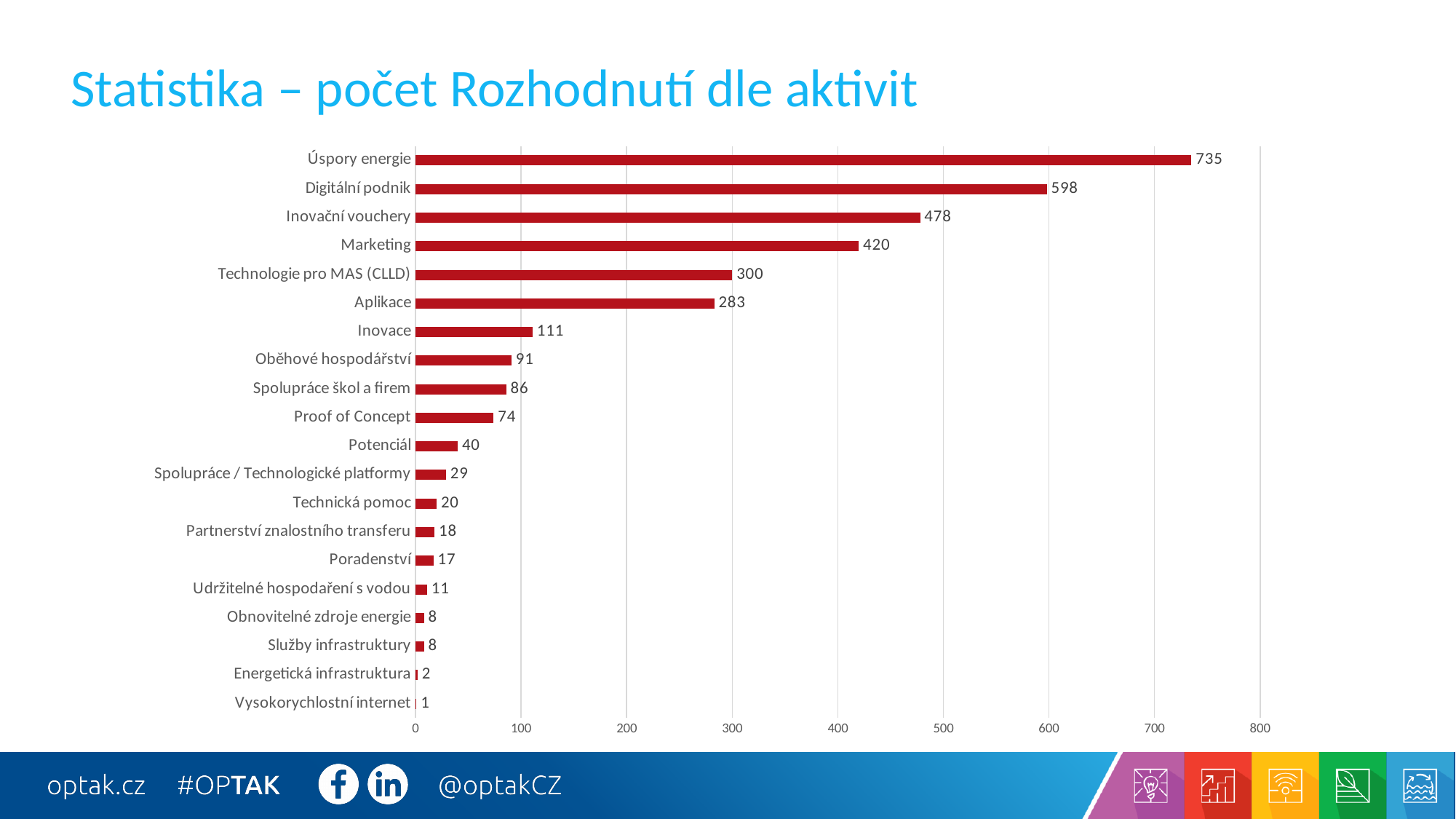
What is the title of the slide? Statistika – počet Rozhodnutí dle aktivit What kind of chart is shown on the slide? bar chart What colour are the bars in the chart? red What is the value for Technologie pro MAS (CLLD)? 300 What is the value for Proof of Concept? 74 Which is larger, the value for Marketing or the value for Aplikace? Marketing How many categories are shown in the chart? 20 Which category has the lowest value? Vysokorychlostní internet Is the value for Inovace greater or less than 100? greater What is the difference between the values for Digitální podnik and Inovační vouchery? 120 Which category has the highest value? Úspory energie What is the value for Úspory energie? 735